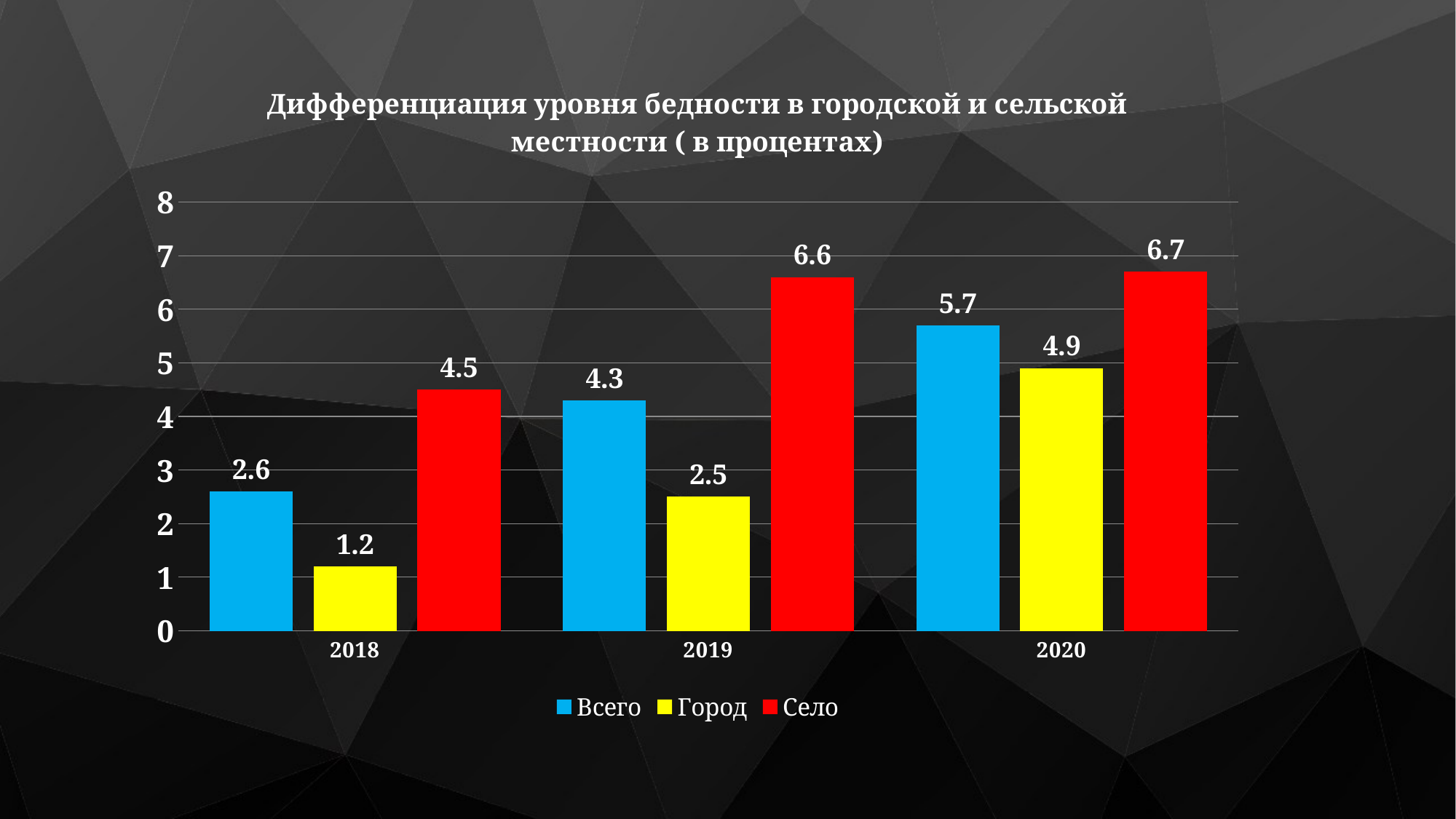
Which is larger in 2019: Всего or Город? Всего In which year is the Город value lowest? 2018 What is the value for Село in 2019? 6.6 What is the value for Всего in 2020? 5.7 Is the value for Всего in 2018 greater or less than 3? less What is the value for Город in 2018? 1.2 In which year is the Село value highest? 2020 How many years are shown on the x axis? 3 How many series does the legend list? 3 Does the Всего value rise or fall from 2018 to 2020? rise What kind of chart is shown on the slide? bar chart What is the difference between the Село and Город values in 2020? 1.8